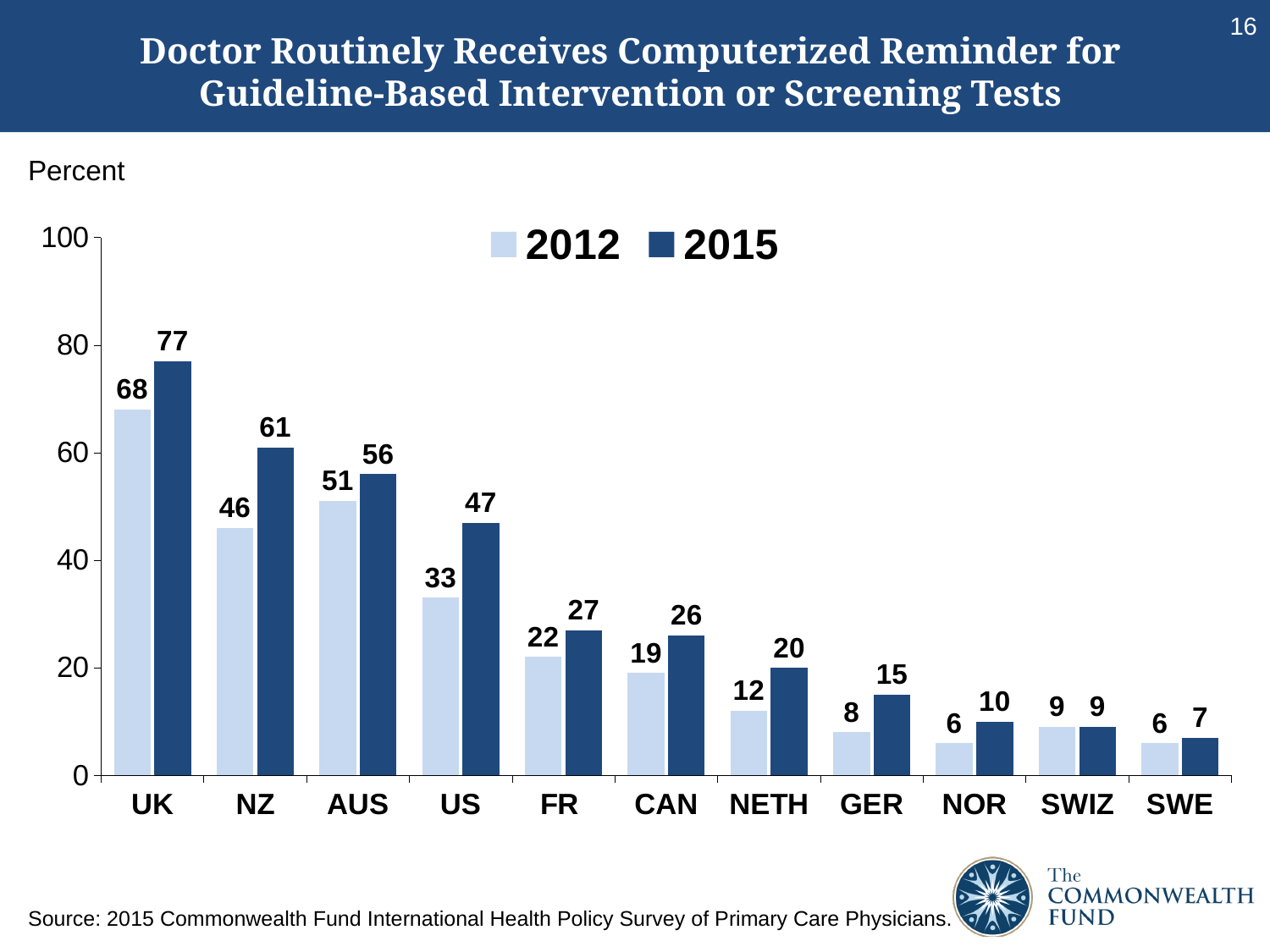
What is the 2012 value for the US? 33 What is the 2012 value for GER? 8 Which two years are listed in the legend? 2012 and 2015 What kind of chart is shown on the slide? Bar chart Which country has the highest 2015 value? UK Do the 2015 values rise or fall moving from left to right along the x axis? Fall How many series does the legend list? 2 What is the difference between the 2015 and 2012 values for NZ? 15 Which is larger, the 2015 value for FR or the 2015 value for CAN? FR Which country has the lowest 2015 value? SWE What is the 2015 value for the UK? 77 How many countries are shown on the x axis? 11